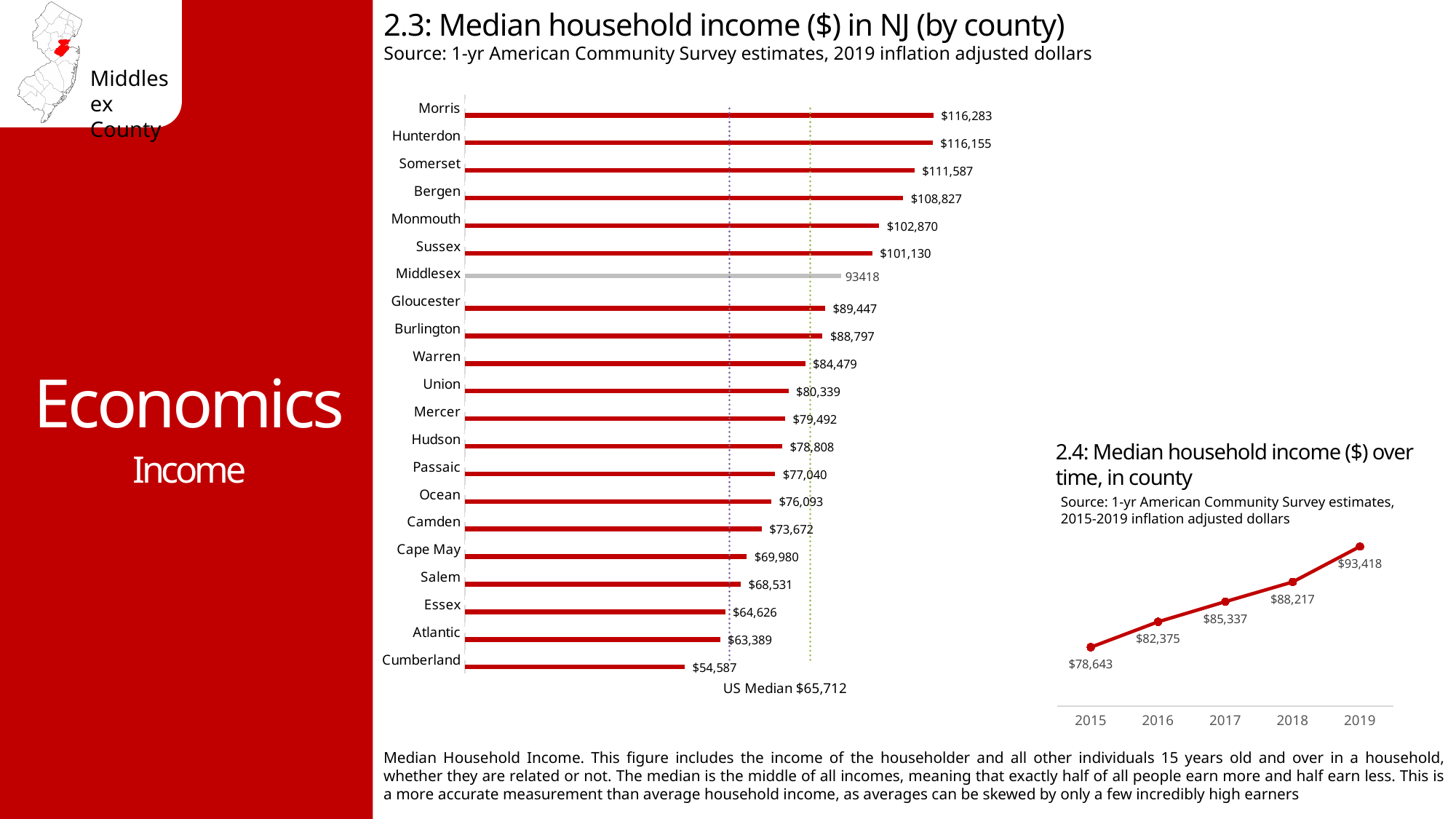
In chart 2.3 (Median household income in NJ by county), which county has the highest median household income? Morris In chart 2.4 (Median household income over time, in county), what is the value for 2017? $85,337 In chart 2.3 (Median household income in NJ by county), what is the value shown for Middlesex? 93418 In chart 2.3 (Median household income in NJ by county), what is the difference between the values for Morris and Cumberland? $61,696 In chart 2.3 (Median household income in NJ by county), how many counties are plotted? 21 In chart 2.3 (Median household income in NJ by county), what US Median value is noted below the bars? $65,712 In chart 2.4 (Median household income over time, in county), do the values rise or fall from 2015 to 2019? Rise In chart 2.3 (Median household income in NJ by county), which county has the lowest median household income? Cumberland In chart 2.4 (Median household income over time, in county), what is the difference between the 2019 and 2015 values? $14,775 In chart 2.3 (Median household income in NJ by county), what is the median household income for Bergen? $108,827 In chart 2.3 (Median household income in NJ by county), which has a higher median household income, Hudson or Camden? Hudson What type of chart is chart 2.3 (Median household income in NJ by county)? Bar chart